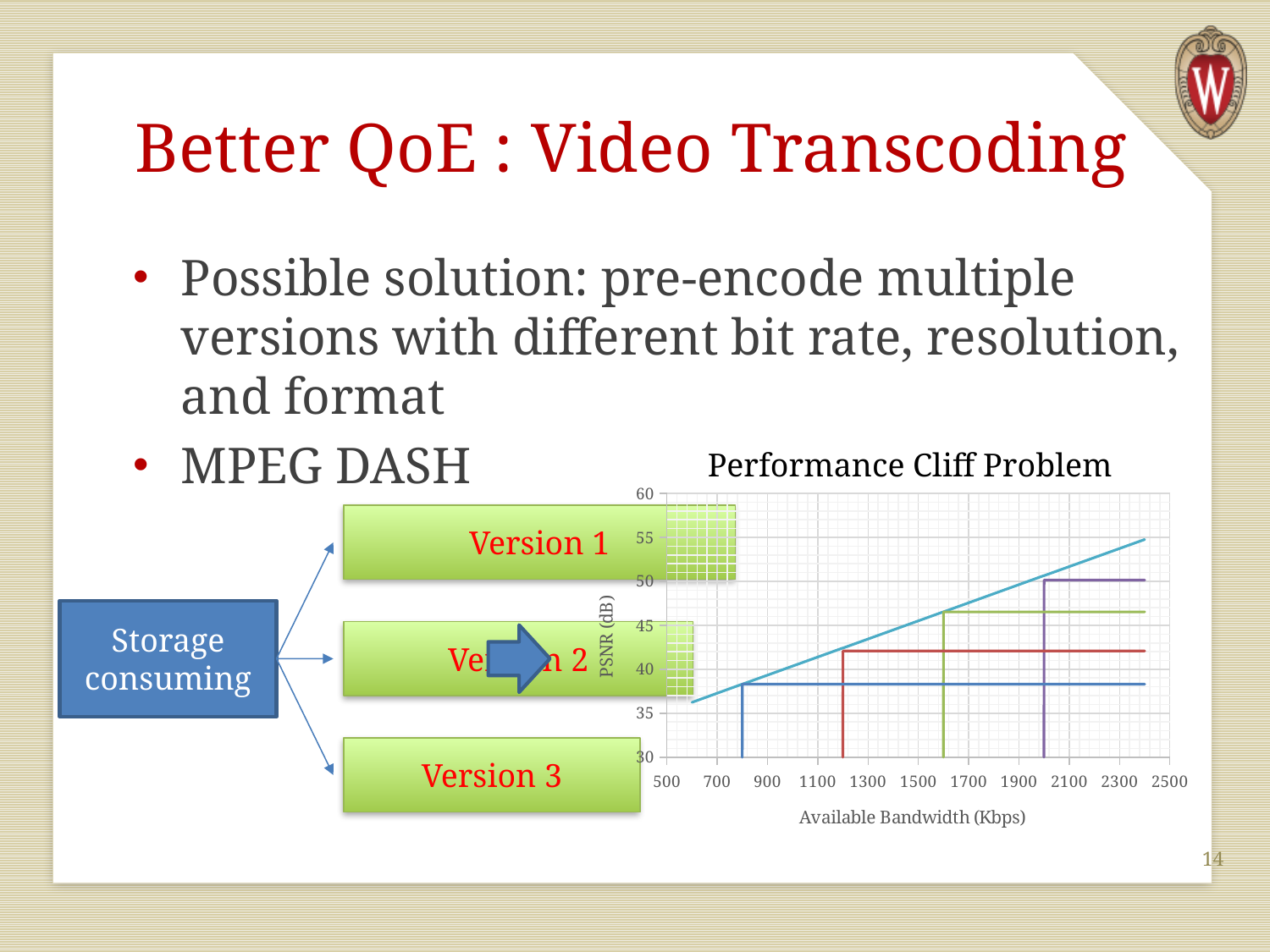
In the Performance Cliff Problem chart, does the diagonal line rise or fall as available bandwidth increases? rise What kind of chart is the Performance Cliff Problem chart? line chart In the Performance Cliff Problem chart, is the flat level of the red step line greater or less than 40 dB? greater In the Performance Cliff Problem chart, which step line reaches a lower PSNR level, the red one or the green one? red In the Performance Cliff Problem chart, is the PSNR value of the diagonal line at 700 Kbps greater or less than 40? less In the Performance Cliff Problem chart, is the flat level of the red step line greater or less than 45 dB? less What is the title of the chart on the slide? Performance Cliff Problem In the Performance Cliff Problem chart, which step line reaches a higher PSNR level, the blue one or the purple one? purple What is the label of the x axis of the Performance Cliff Problem chart? Available Bandwidth (Kbps)